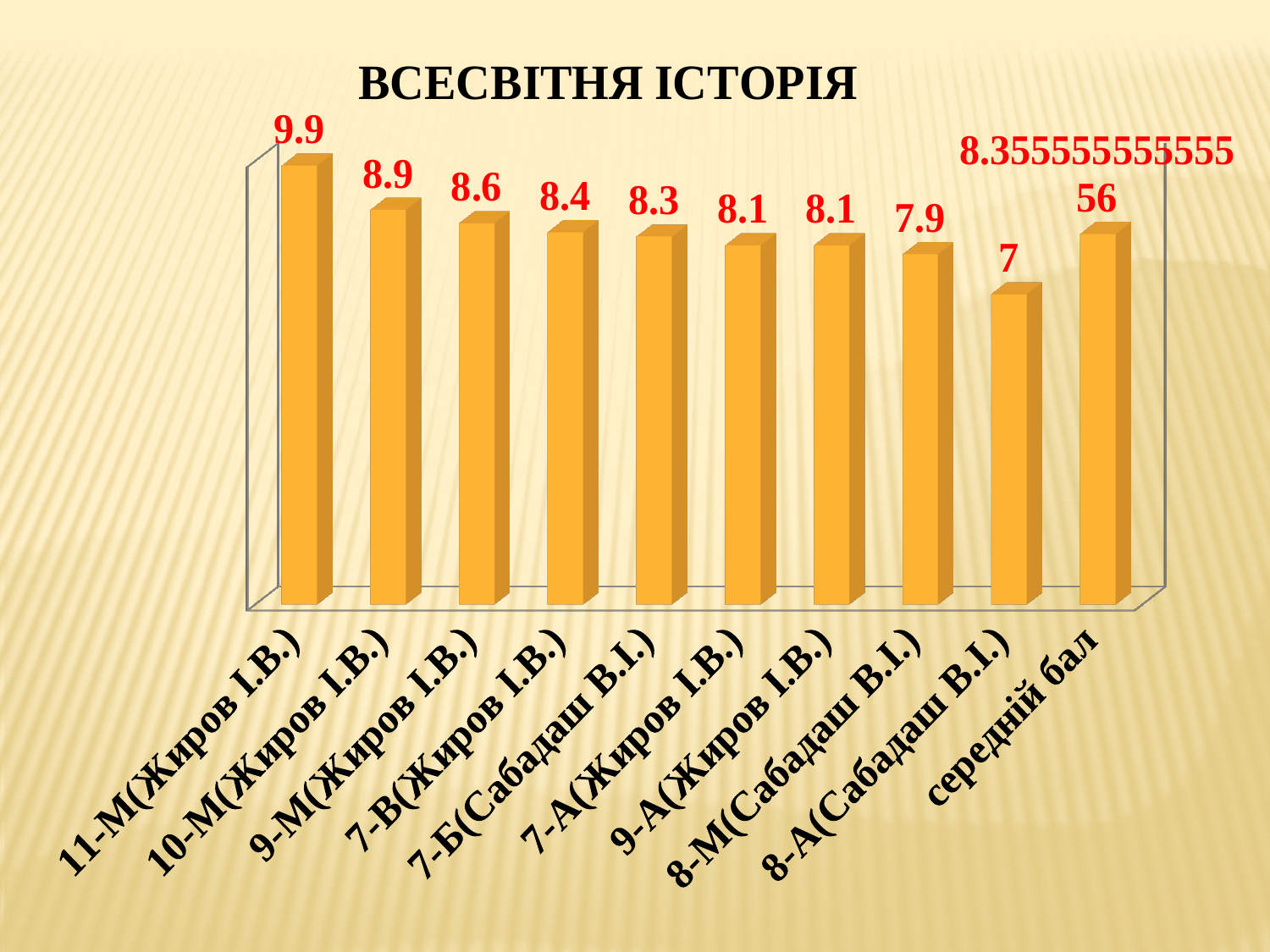
Which is larger, the value for 7-В(Жиров І.В.) or the value for 7-А(Жиров І.В.)? 7-В(Жиров І.В.) Which category has the lowest value? 8-А(Сабадаш В.І.) How many bars does the chart have? 10 Do the values for the class bars (from 11-М to 8-А) rise or fall from left to right? fall What is the difference between the values for 10-М(Жиров І.В.) and 9-М(Жиров І.В.)? 0.3 What kind of chart is shown on the slide? bar chart What is the value for 11-М(Жиров І.В.)? 9.9 What is the title of the chart? ВСЕСВІТНЯ ІСТОРІЯ Which category has the highest value? 11-М(Жиров І.В.) What is the value for 8-М(Сабадаш В.І.)? 7.9 What is the difference between the values for 11-М(Жиров І.В.) and 8-А(Сабадаш В.І.)? 2.9 What is the value for 7-Б(Сабадаш В.І.)? 8.3